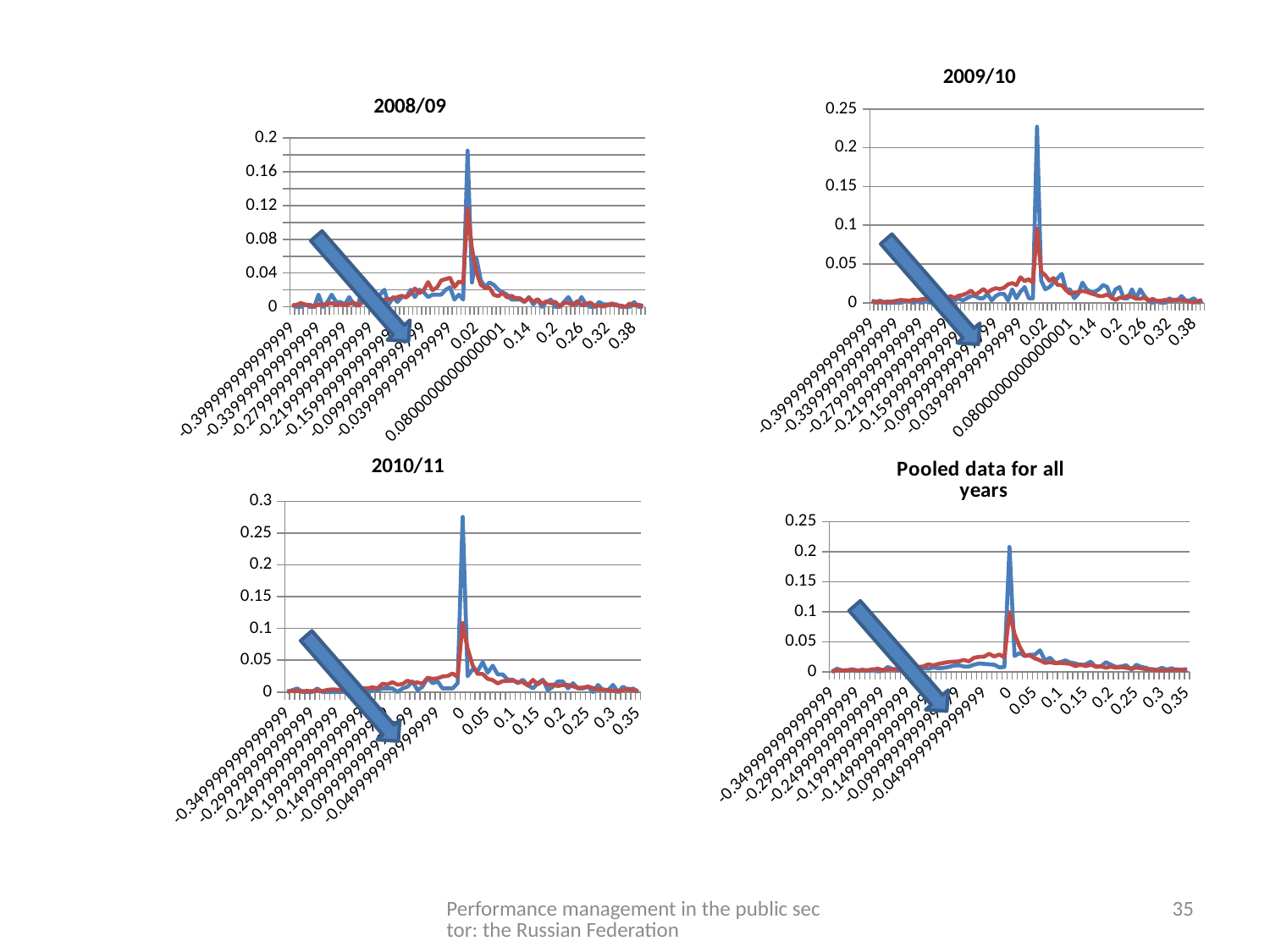
What is the title of the chart in the bottom-right position of the slide? Pooled data for all years In the 2008/09 chart, how many lines are plotted? 2 In the 2008/09 chart, is the peak value of the red line greater or less than 0.08? greater In the 2010/11 chart, which line reaches a higher peak, the blue line or the red line? the blue line What kind of chart is the 2008/09 chart? line chart In the 'Pooled data for all years' chart, is the peak value of the blue line greater or less than 0.15? greater In the 2010/11 chart, is the peak value of the blue line greater or less than 0.25? greater In the 2009/10 chart, which line reaches a higher peak, the blue line or the red line? the blue line Which of the four charts has the highest peak value on its blue line? 2010/11 How many charts are shown on the slide? 4